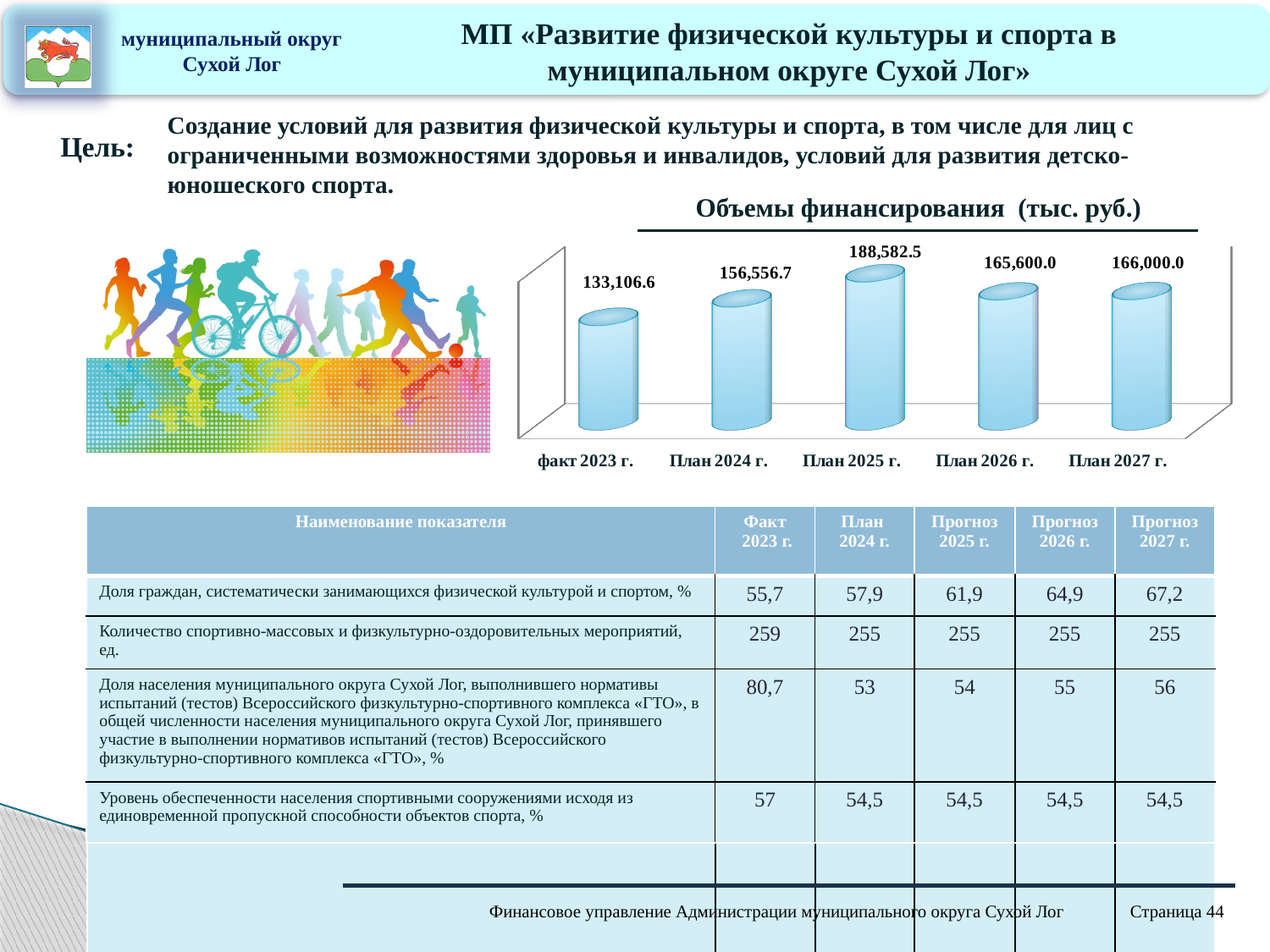
Which is larger in the chart «Объемы финансирования (тыс. руб.)»: the value for План 2024 г. or the value for План 2026 г.? План 2026 г. What kind of chart is «Объемы финансирования (тыс. руб.)»? bar chart Which category has the highest value in the chart «Объемы финансирования (тыс. руб.)»? План 2025 г. What is the difference between the values for План 2025 г. and факт 2023 г. in the chart «Объемы финансирования (тыс. руб.)»? 55,475.9 What is the difference between the values for План 2027 г. and План 2026 г. in the chart «Объемы финансирования (тыс. руб.)»? 400.0 In the chart «Объемы финансирования (тыс. руб.)», do the values rise or fall from факт 2023 г. to План 2025 г.? rise What is the value for План 2025 г. in the chart «Объемы финансирования (тыс. руб.)»? 188,582.5 What is the value for План 2027 г. in the chart «Объемы финансирования (тыс. руб.)»? 166,000.0 How many categories are shown in the chart «Объемы финансирования (тыс. руб.)»? 5 Which category has the lowest value in the chart «Объемы финансирования (тыс. руб.)»? факт 2023 г. What is the value for факт 2023 г. in the chart «Объемы финансирования (тыс. руб.)»? 133,106.6 What is the value for План 2024 г. in the chart «Объемы финансирования (тыс. руб.)»? 156,556.7